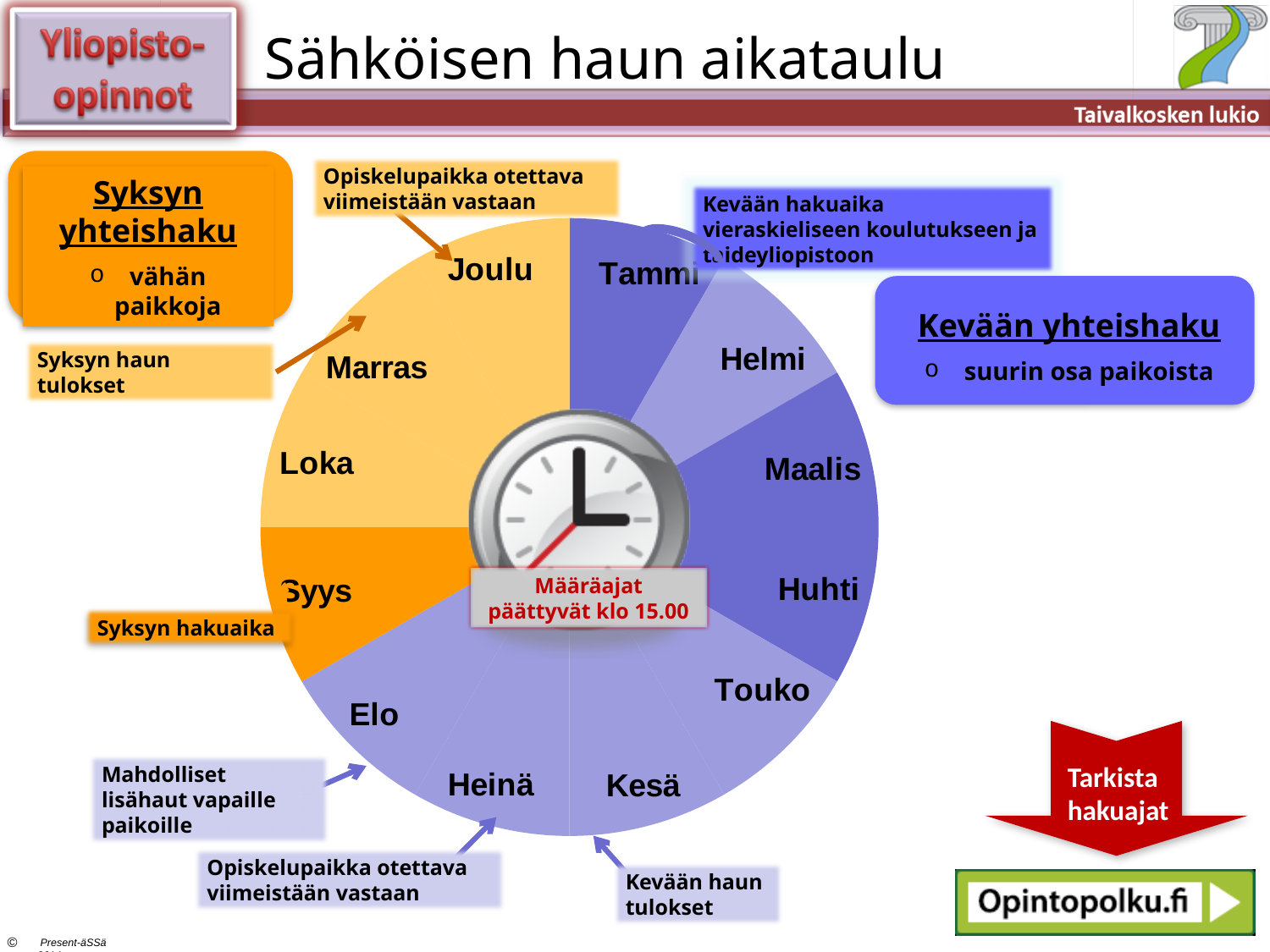
Which slice of the pie chart is labelled between Elo and Kesä? Heinä How many slices does the pie chart have? 12 What text is shown in the box at the centre of the pie chart? Määräajat päättyvät klo 15.00 What is the title of the slide containing the pie chart? Sähköisen haun aikataulu What kind of chart is shown on the slide? pie chart Which slice of the pie chart is labelled between Loka and Joulu? Marras Which slice of the pie chart is labelled between Helmi and Huhti? Maalis Which slice of the pie chart comes clockwise right after Joulu? Tammi